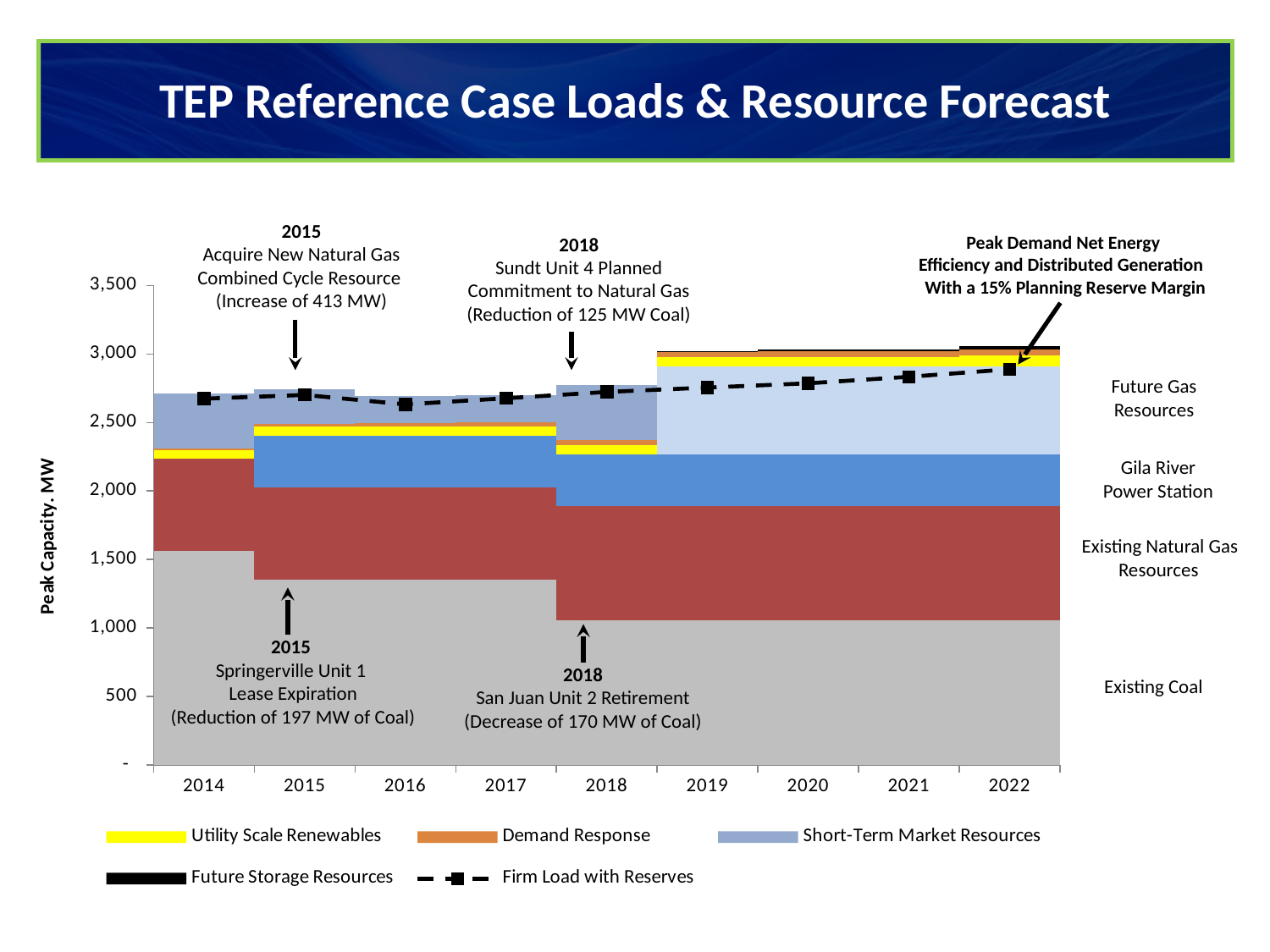
Does the Existing Coal capacity rise or fall from 2014 to 2018? falls What kind of chart is shown on the slide? Stacked bar chart with a line Is the Firm Load with Reserves value in 2014 greater or less than 3,000? less What is the label of the y axis? Peak Capacity, MW According to the chart annotation, by how many MW does the new natural gas combined cycle resource acquired in 2015 increase capacity? 413 MW How many years are shown on the x axis of the chart? 9 Does the Firm Load with Reserves line rise or fall from 2018 to 2022? rises Is the Existing Coal capacity in 2015 greater or less than 1,500? less How many series does the chart's legend list? 5 What is the title of the chart? TEP Reference Case Loads & Resource Forecast According to the chart annotation, how much coal capacity is reduced by the Springerville Unit 1 lease expiration in 2015? 197 MW